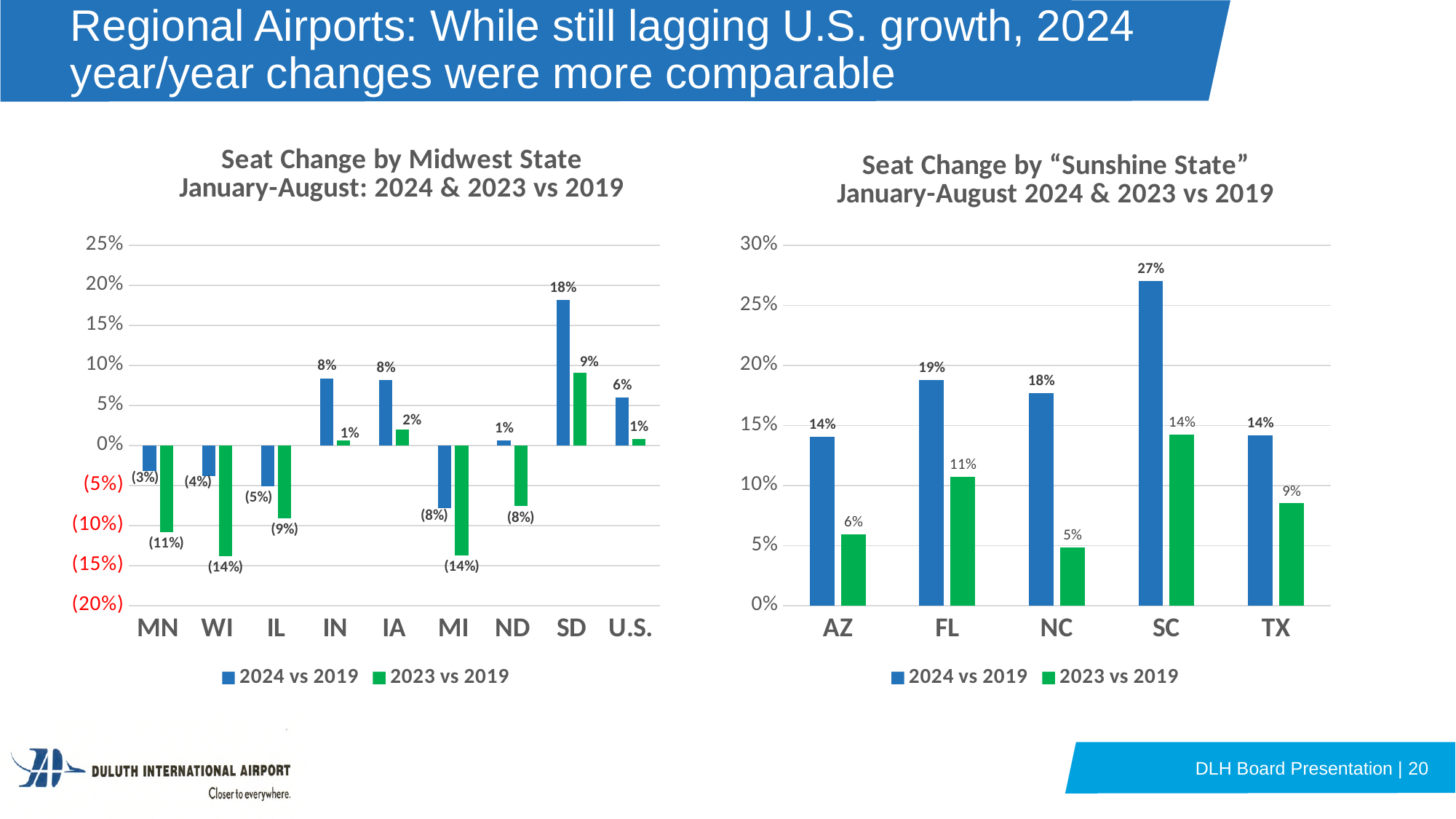
In the Seat Change by Midwest State chart, which state has the highest 2024 vs 2019 value? SD In the Seat Change by "Sunshine State" chart, how many series does the legend list? 2 In the Seat Change by Midwest State chart, what is the 2024 vs 2019 value for U.S.? 6% In the Seat Change by Midwest State chart, what is the 2023 vs 2019 value for WI? (14%) In the Seat Change by "Sunshine State" chart, what is the difference between the 2024 vs 2019 and 2023 vs 2019 values for FL? 8% In the Seat Change by "Sunshine State" chart, which is larger for TX: the 2024 vs 2019 value or the 2023 vs 2019 value? 2024 vs 2019 In the Seat Change by "Sunshine State" chart, which state has the lowest 2023 vs 2019 value? NC In the Seat Change by Midwest State chart, how many states/categories are shown on the x axis? 9 In the Seat Change by Midwest State chart, which colour represents the 2023 vs 2019 series? Green What type of chart is the Seat Change by "Sunshine State" chart? Bar chart In the Seat Change by "Sunshine State" chart, what is the 2024 vs 2019 value for SC? 27% In the Seat Change by Midwest State chart, what is the 2024 vs 2019 value for SD? 18%